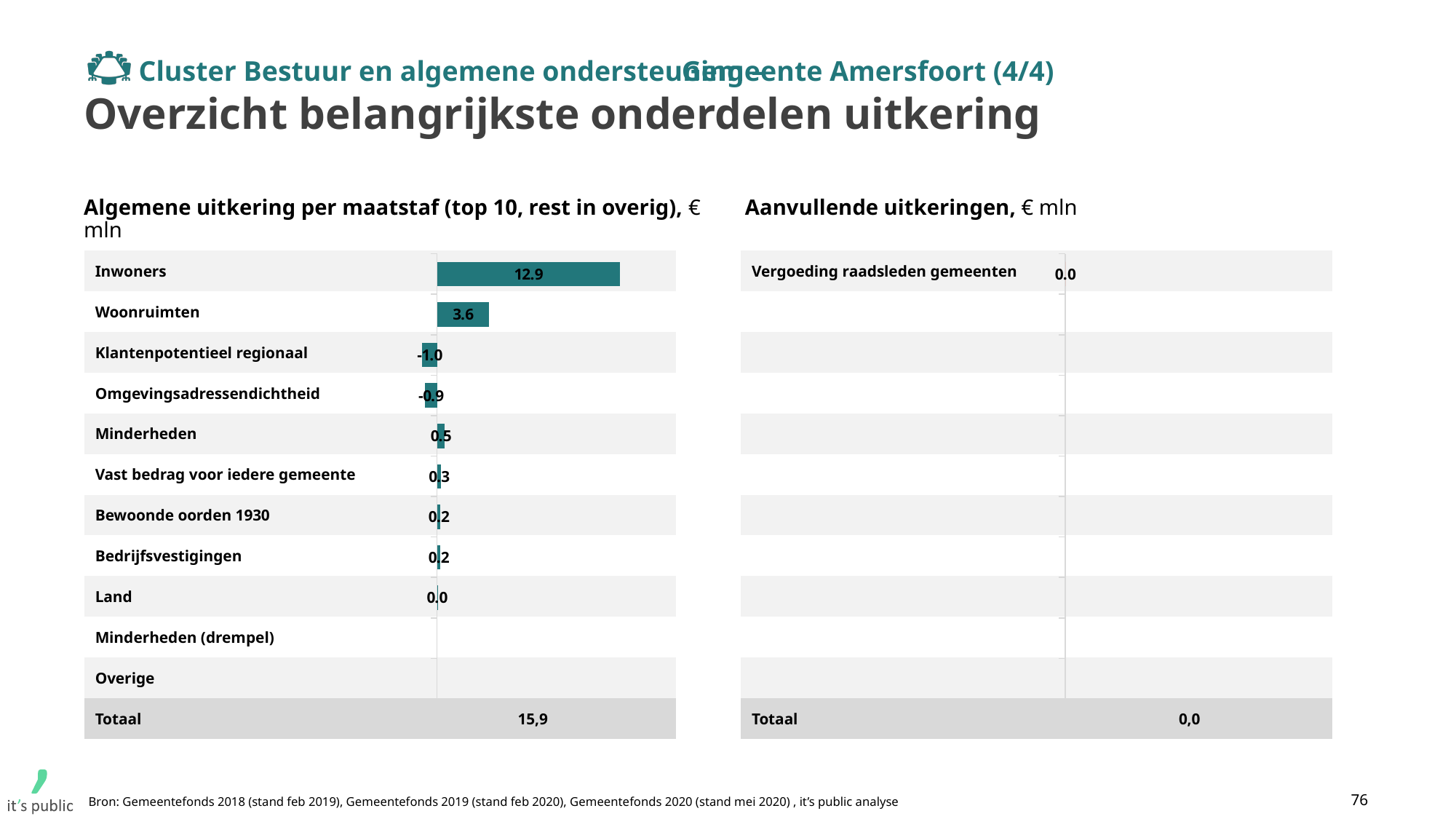
In the chart 'Algemene uitkering per maatstaf', how many categories have a negative value? 2 What kind of chart is the 'Algemene uitkering per maatstaf' chart? Bar chart In the chart 'Algemene uitkering per maatstaf', what is the value for Omgevingsadressendichtheid? -0.9 In the chart 'Algemene uitkering per maatstaf', what is the value for Inwoners? 12.9 In the chart 'Aanvullende uitkeringen', what is the value for Vergoeding raadsleden gemeenten? 0.0 In the chart 'Algemene uitkering per maatstaf', which category has the lowest value? Klantenpotentieel regionaal In the chart 'Algemene uitkering per maatstaf', what is the value for Klantenpotentieel regionaal? -1.0 In the chart 'Algemene uitkering per maatstaf', what is the value for Woonruimten? 3.6 In the chart 'Algemene uitkering per maatstaf', which category has the highest value? Inwoners In the chart 'Algemene uitkering per maatstaf', what is the difference between the values for Inwoners and Woonruimten? 9.3 In the chart 'Algemene uitkering per maatstaf', what is the Totaal shown at the bottom? 15,9 In the chart 'Algemene uitkering per maatstaf', which is larger: the value for Minderheden or the value for Vast bedrag voor iedere gemeente? Minderheden